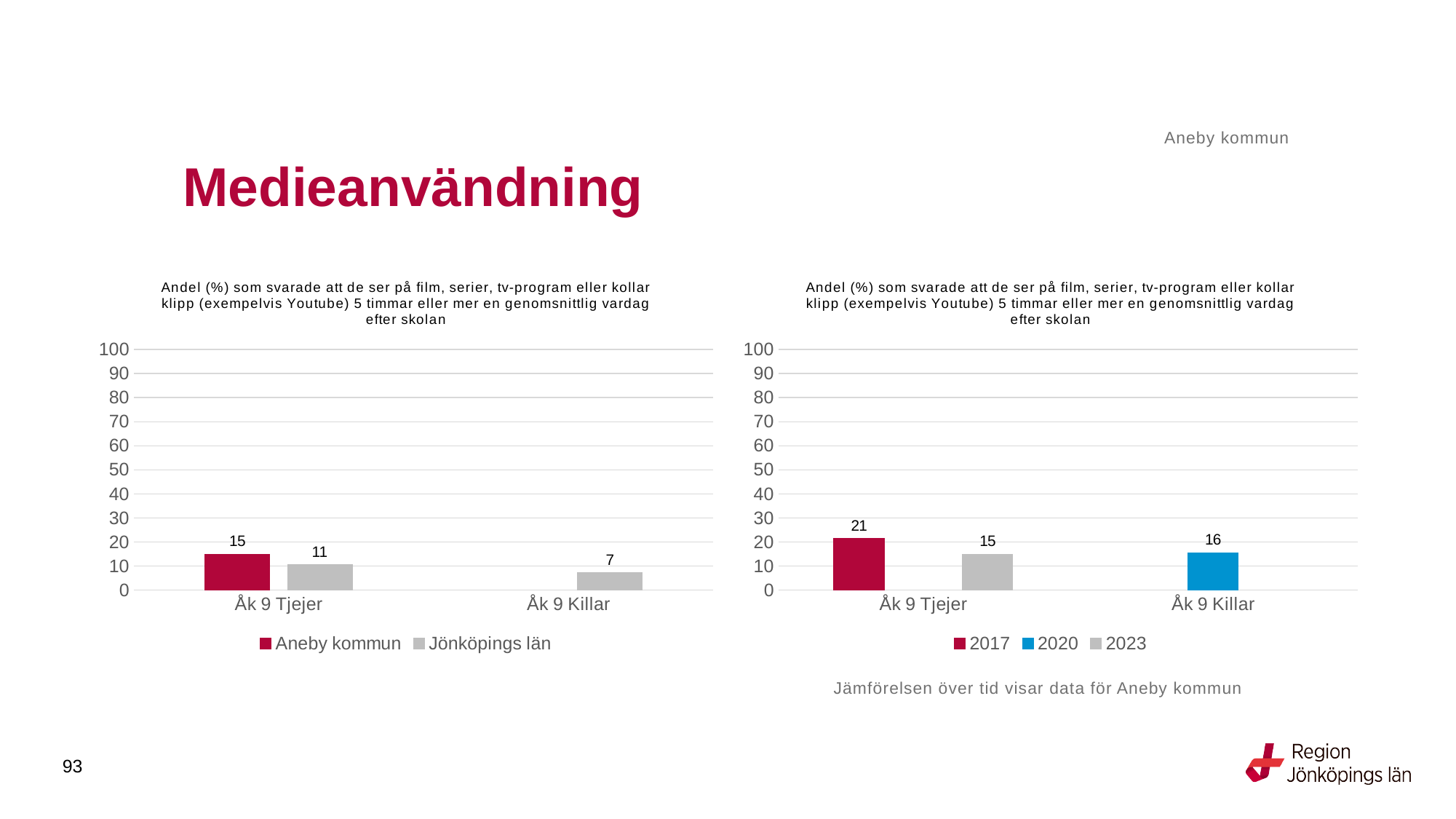
In the right chart, how many series does the legend list? 3 In the right chart, what is the value for 2017 for Åk 9 Tjejer? 21 In the left chart, what is the difference between Aneby kommun and Jönköpings län for Åk 9 Tjejer? 4 In the left chart, what is the value for Jönköpings län for Åk 9 Killar? 7 What kind of chart is the right chart? Bar chart In the left chart, what is the value for Aneby kommun for Åk 9 Tjejer? 15 In the left chart, which is larger for Åk 9 Tjejer: Aneby kommun or Jönköpings län? Aneby kommun In the left chart, how many series does the legend list? 2 In the right chart, what is the value for 2023 for Åk 9 Tjejer? 15 In the right chart, what is the value for 2020 for Åk 9 Killar? 16 In the right chart, what is the difference between the 2017 and 2023 values for Åk 9 Tjejer? 6 In the left chart, what is the value for Jönköpings län for Åk 9 Tjejer? 11